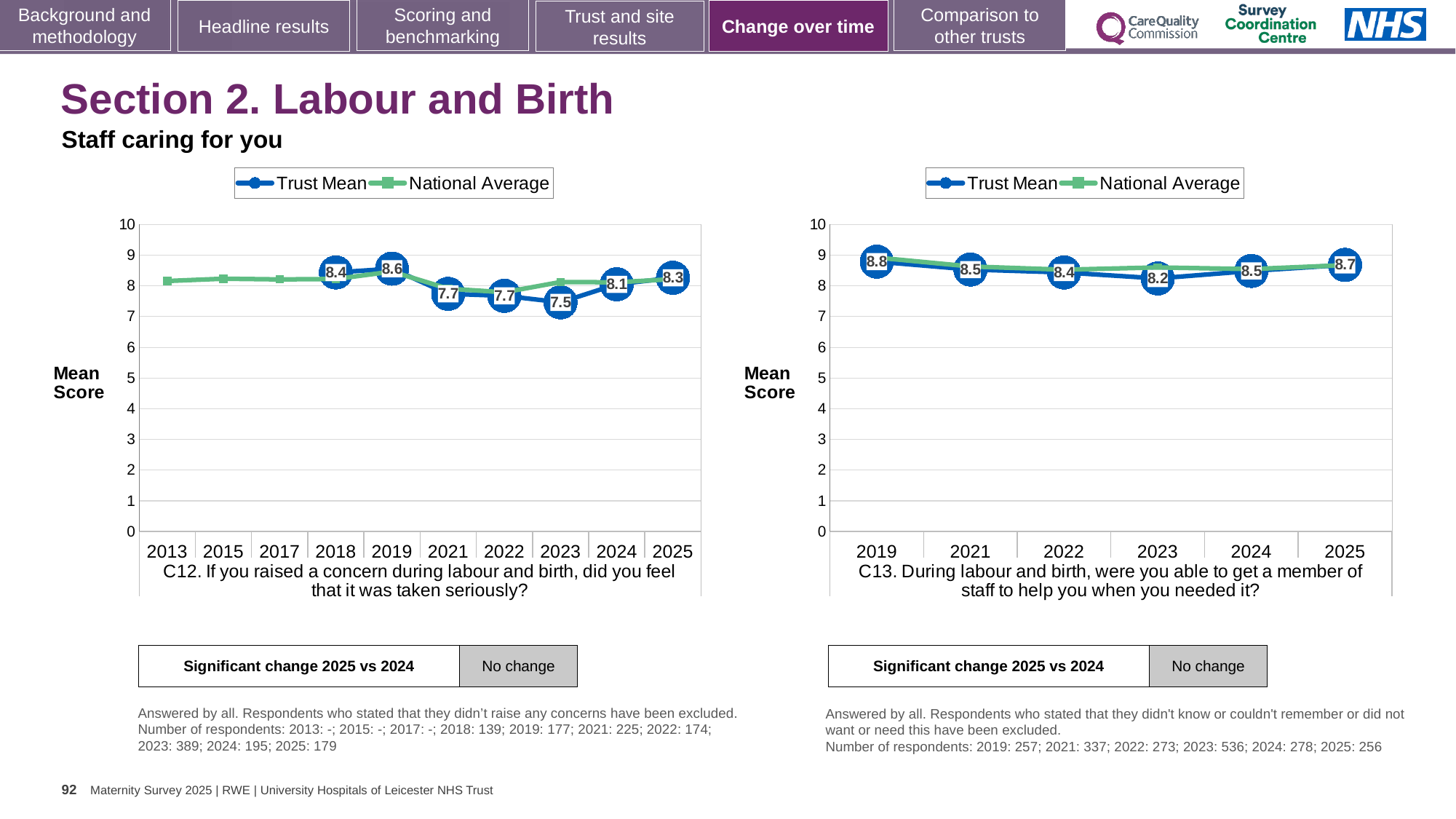
In the right chart (C13), is the Trust Mean for 2025 greater or less than 8? greater In the right chart (C13), which year has the highest Trust Mean? 2019 In the left chart (C12), what is the difference between the Trust Mean for 2025 and 2024? 0.2 In the left chart (C12), which year has the lowest Trust Mean? 2023 In the left chart (C12), which year has the highest Trust Mean? 2019 In the left chart (C12), what is the Trust Mean for 2019? 8.6 In the right chart (C13), what is the Trust Mean for 2023? 8.2 In the right chart (C13), what is the difference between the Trust Mean for 2019 and 2023? 0.6 In the left chart (C12), what is the Trust Mean for 2023? 7.5 What kind of chart is the left chart (C12)? Line chart How many series does the legend of the right chart (C13) list? 2 In the left chart (C12), how many years are shown on the x axis? 10